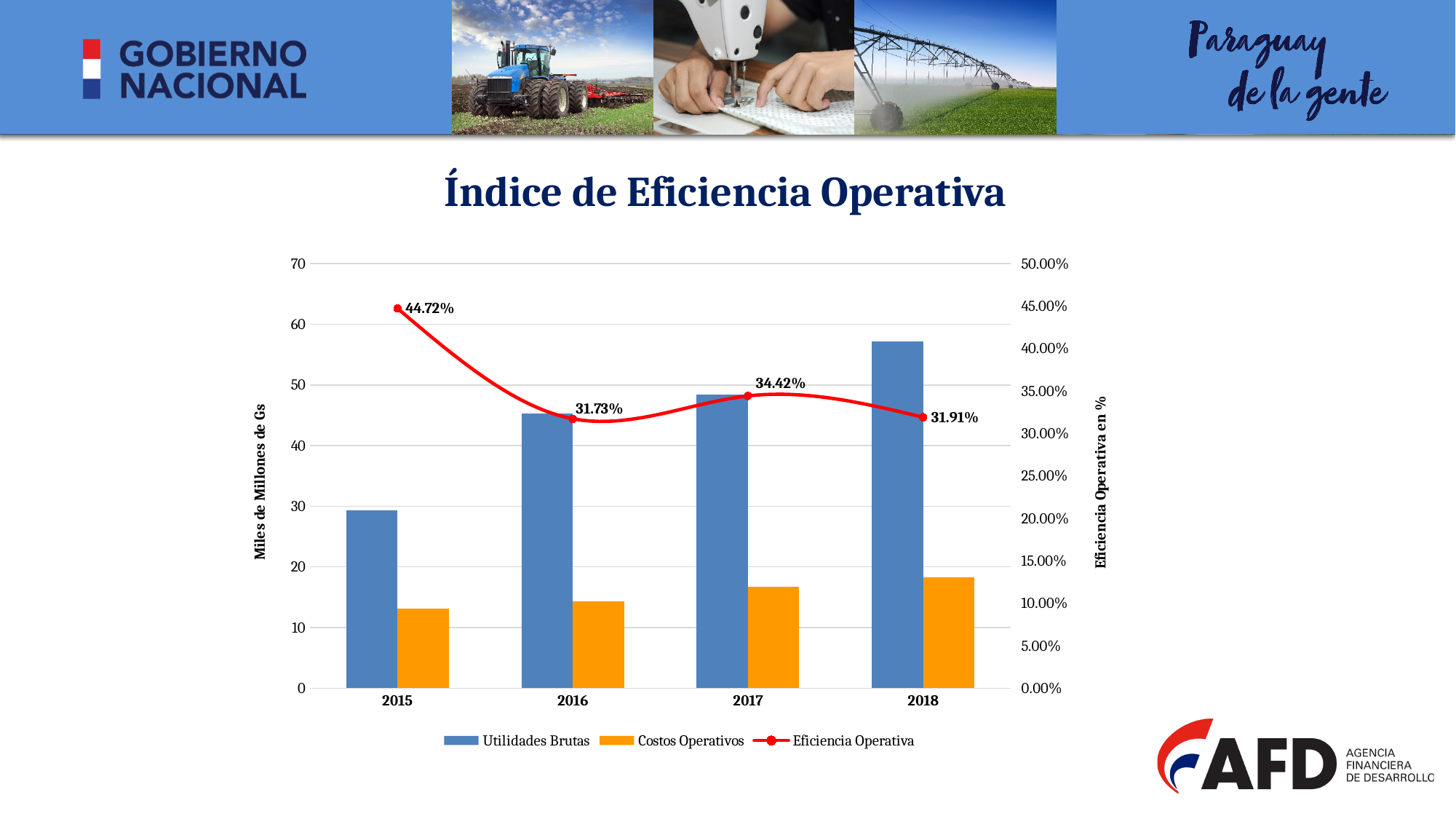
What is the Eficiencia Operativa value for 2017? 34.42% Is the Costos Operativos value for 2015 greater or less than 20? less Is the Utilidades Brutas value for 2018 greater or less than 50? greater How many years are shown on the x axis? 4 What kind of chart is shown on the slide? Combination bar and line chart Do the Utilidades Brutas bars rise or fall from 2015 to 2018? Rise Which year has the higher Eficiencia Operativa, 2017 or 2018? 2017 In which year is the Eficiencia Operativa highest? 2015 How many series does the legend list? 3 By how many percentage points did the Eficiencia Operativa fall from 2015 to 2016? 12.99 percentage points What is the Eficiencia Operativa value for 2015? 44.72% In which year is the Eficiencia Operativa lowest? 2016